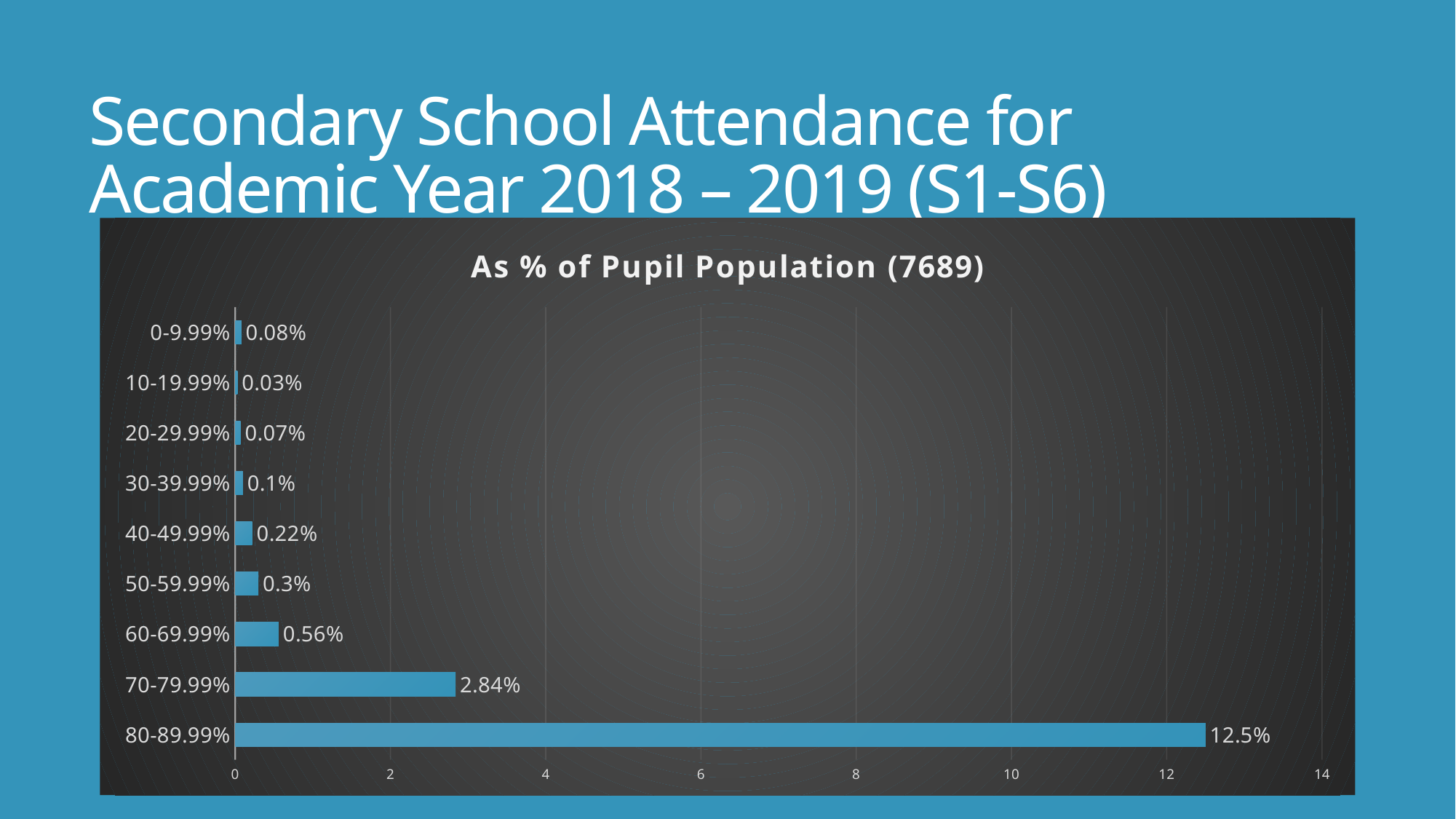
What is the value for the 70-79.99% attendance band? 2.84% What is the value for the 10-19.99% attendance band? 0.03% What is the value for the 80-89.99% attendance band? 12.5% What is the title of the chart? As % of Pupil Population (7689) What is the value for the 60-69.99% attendance band? 0.56% Which is larger, the value for 40-49.99% or the value for 50-59.99%? 50-59.99% Which attendance band has the lowest value? 10-19.99% Which attendance band has the highest value? 80-89.99% What kind of chart is shown on the slide? bar chart What is the difference between the values for the 80-89.99% and 70-79.99% bands? 9.66% Is the value for the 80-89.99% band greater or less than 12? greater How many attendance bands are shown on the chart? 9